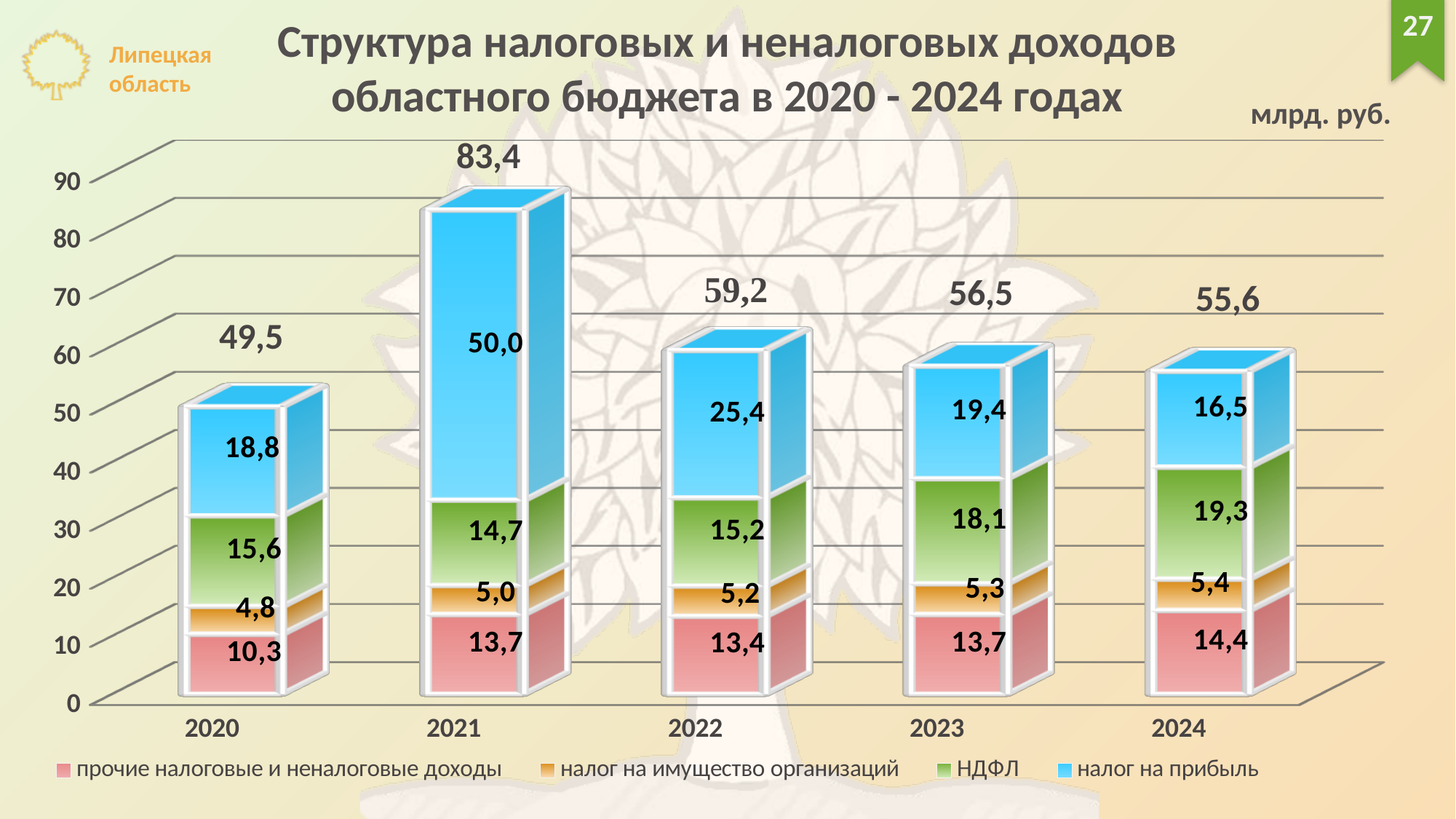
What is the value of налог на прибыль in 2022? 25,4 What is the value of НДФЛ in 2024? 19,3 Which year has the highest total of tax and non-tax revenues? 2021 How many series does the legend list? 4 What type of chart is shown on the slide? stacked bar chart How many years (categories) are shown on the x axis? 5 What is the total value printed above the bar for 2021? 83,4 Does the value of налог на прибыль rise or fall from 2021 to 2024? fall What is the value of налог на имущество организаций in 2020? 4,8 What is the difference between the налог на прибыль values in 2021 and 2020? 31,2 Which is larger: прочие налоговые и неналоговые доходы in 2024 or in 2022? 2024 Which year has the lowest total of tax and non-tax revenues? 2020